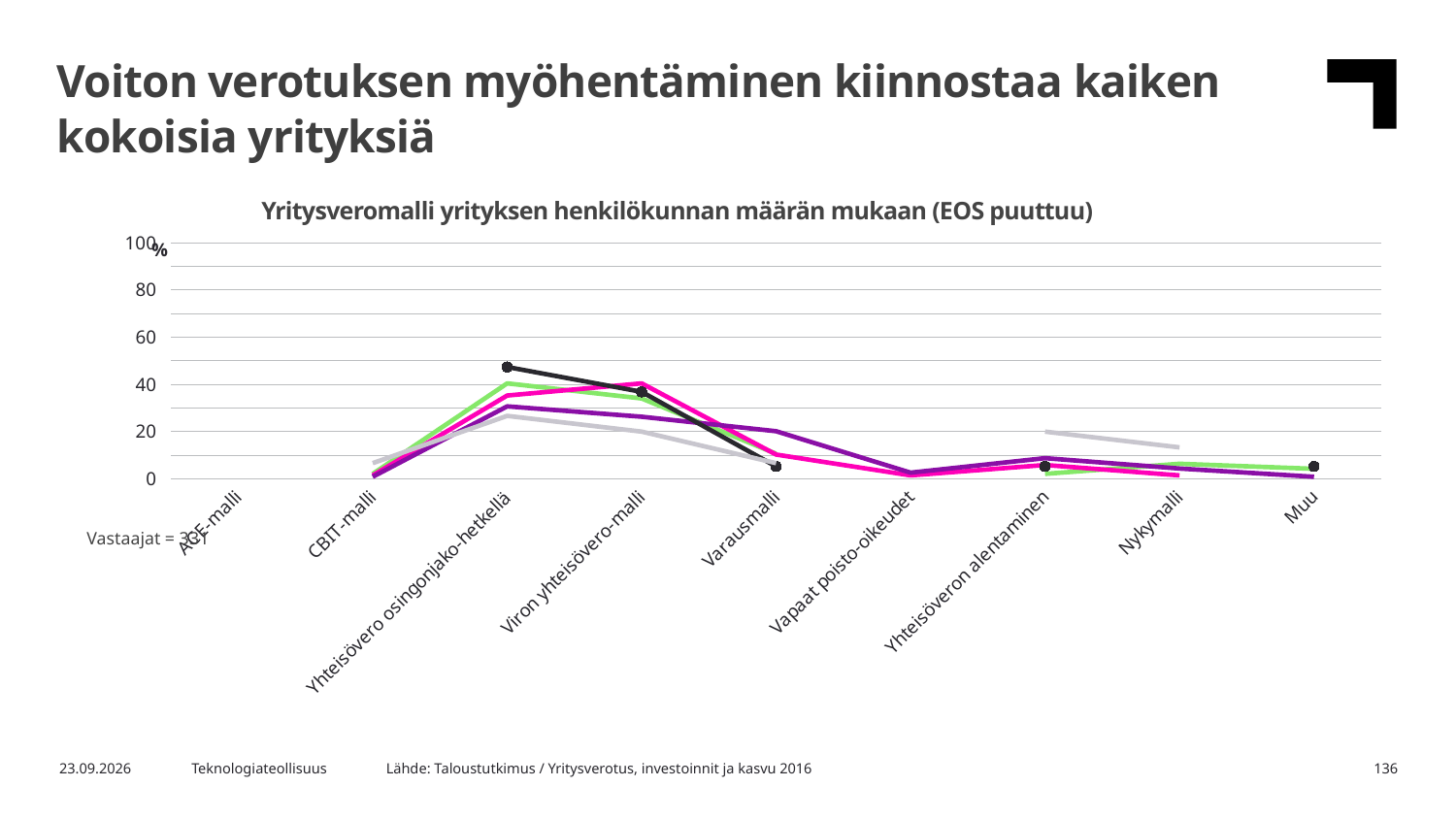
For the magenta line, which category has the highest value? Viron yhteisövero-malli What kind of chart is shown on the slide? line chart How many categories are shown along the x axis of the chart? 9 Is the value of the black line for Yhteisövero osingonjako-hetkellä greater or less than 40? greater Is the value of the black line for Varausmalli greater or less than 20? less For the black line, which category has the highest value? Yhteisövero osingonjako-hetkellä At Varausmalli, which line has the larger value, the purple line or the black line? the purple line Is the value of the magenta line for Viron yhteisövero-malli greater or less than 20? greater What is the title of the chart? Yritysveromalli yrityksen henkilökunnan määrän mukaan (EOS puuttuu) At Yhteisövero osingonjako-hetkellä, which line has the larger value, the black line or the grey line? the black line For the grey line, which category has the highest value? Yhteisövero osingonjako-hetkellä